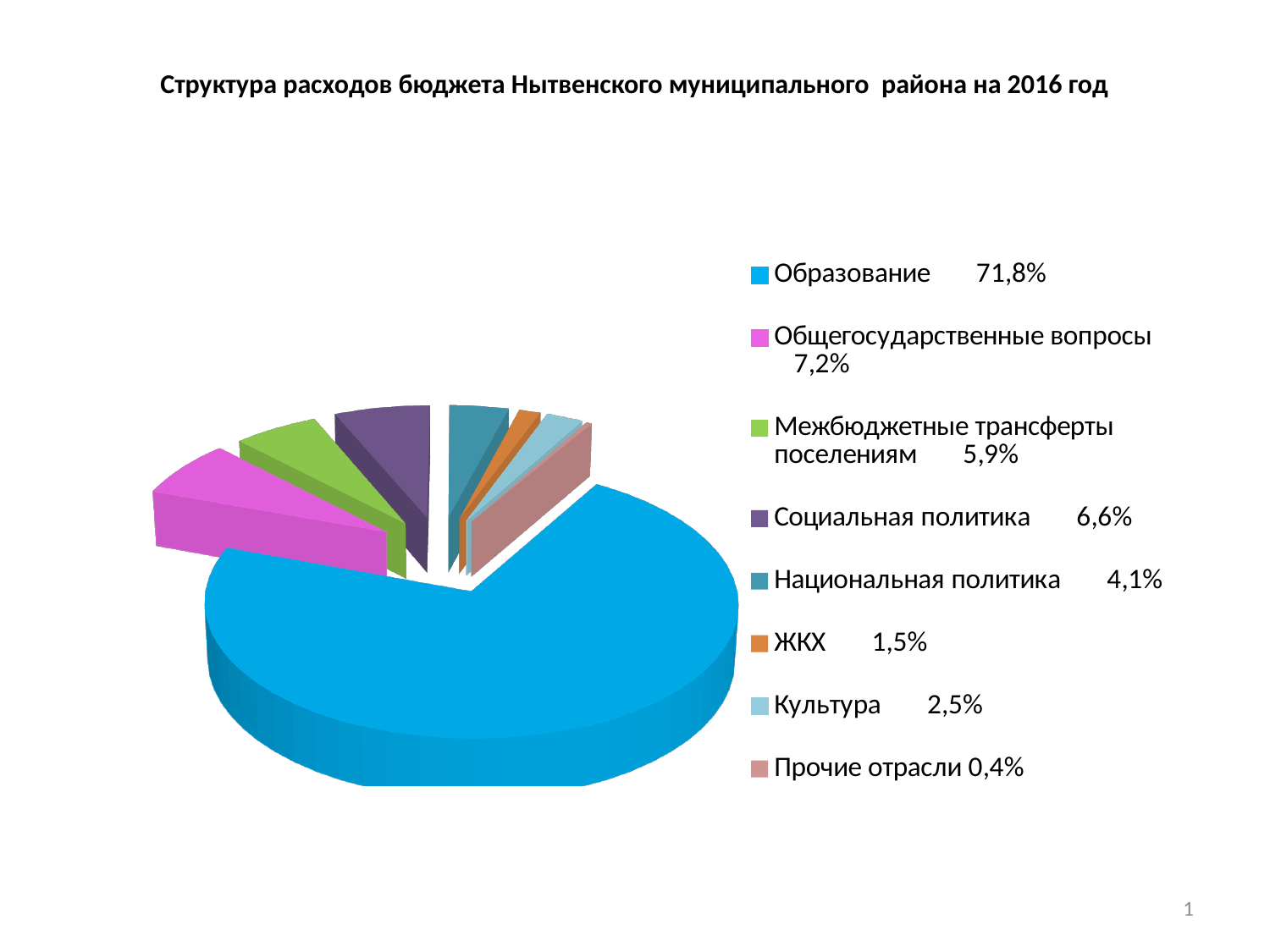
What kind of chart is shown on the slide? Pie chart What share of the budget expenditure goes to Образование? 71,8% Which category has the smallest share of the budget? Прочие отрасли What is the title of the chart? Структура расходов бюджета Нытвенского муниципального района на 2016 год Which is larger: Социальная политика or Общегосударственные вопросы? Общегосударственные вопросы What is the difference between the shares of Образование and Общегосударственные вопросы? 64,6% What is the value for ЖКХ? 1,5% How many categories does the pie chart show? 8 What is the value for Национальная политика? 4,1% Which category has the largest share of the budget? Образование What is the value for Общегосударственные вопросы? 7,2% What is the value for Межбюджетные трансферты поселениям? 5,9%